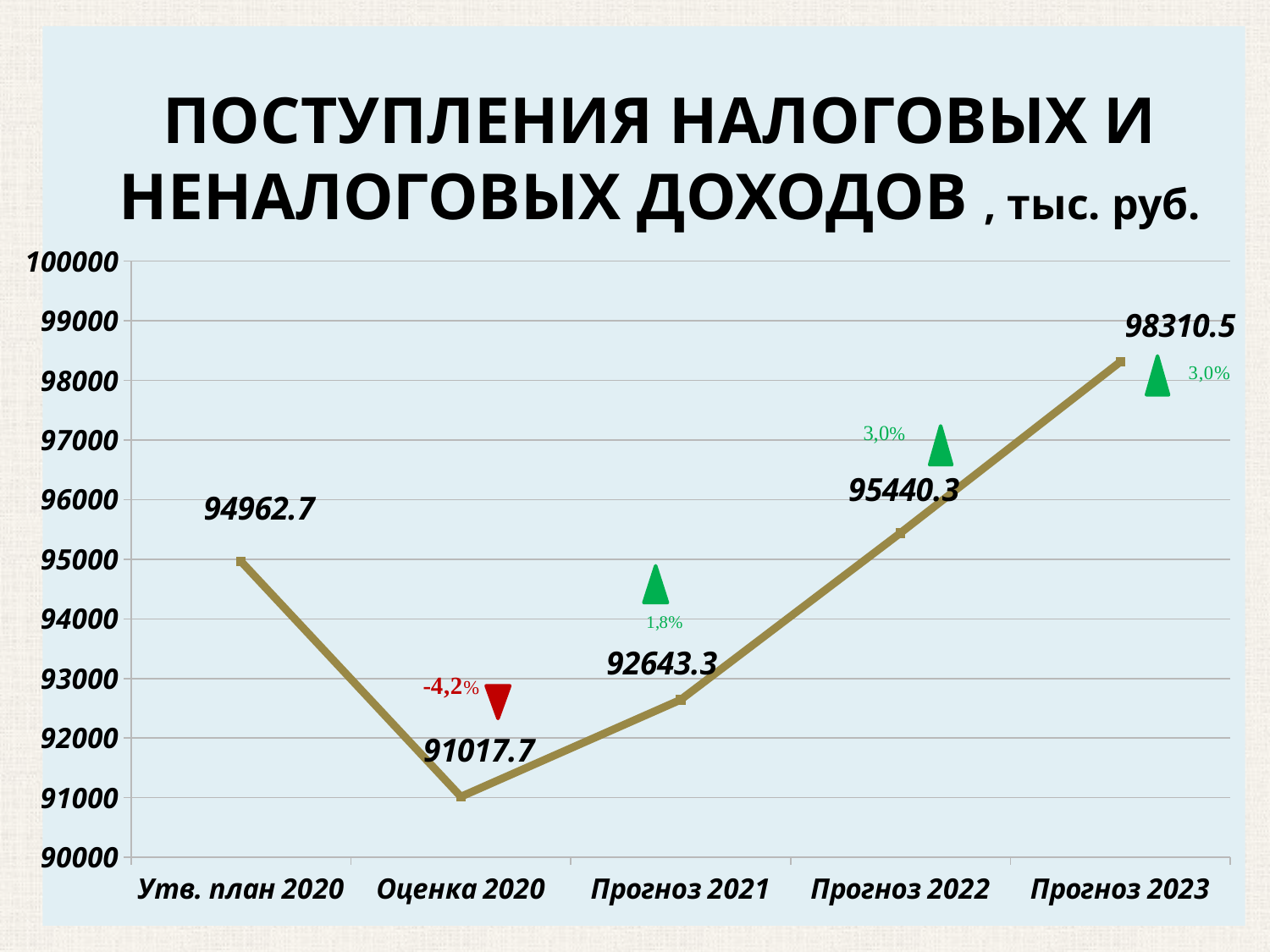
What is the difference between the values for Прогноз 2023 and Прогноз 2022? 2870.2 What is the value for Прогноз 2023? 98310.5 What is the value for Прогноз 2022? 95440.3 What kind of chart is shown on the slide? Line chart What is the difference between the values for Утв. план 2020 and Оценка 2020? 3945.0 What is the value for Утв. план 2020? 94962.7 What is the value for Оценка 2020? 91017.7 Which is larger, the value for Утв. план 2020 or the value for Прогноз 2021? Утв. план 2020 Which category has the highest value? Прогноз 2023 Which category has the lowest value? Оценка 2020 How many categories are plotted on the x axis? 5 What percentage change is shown next to the red arrow at Оценка 2020? -4,2%